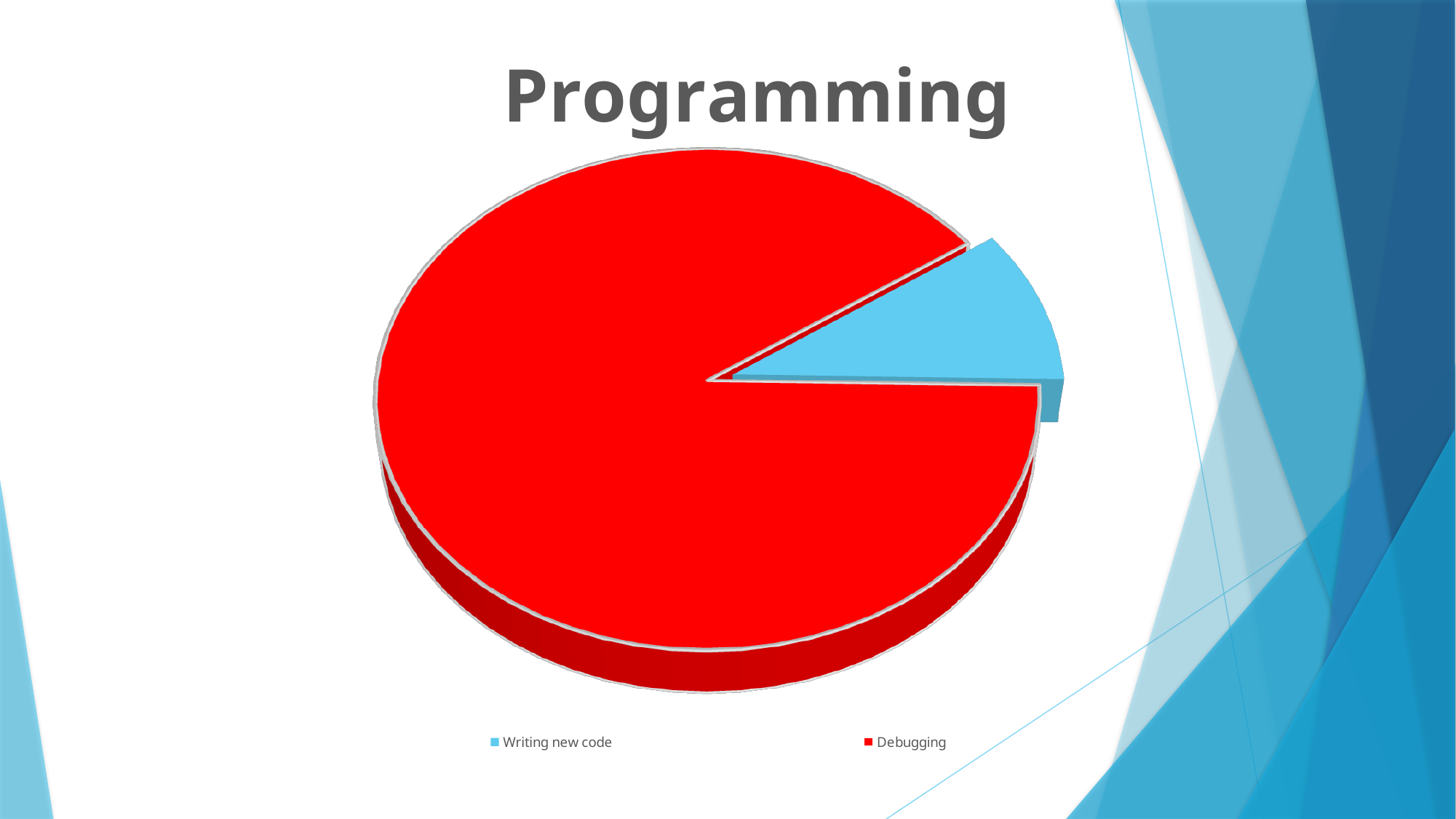
Does the Debugging slice take up more or less than half of the pie? more Which category is shown in blue in the legend? Writing new code Which category has the smallest slice of the pie? Writing new code What kind of chart is shown on the slide? pie chart How many slices does the pie chart have? 2 What is the title of the chart? Programming Which slice is larger, Writing new code or Debugging? Debugging Which category has the largest slice of the pie? Debugging What colour is the Debugging slice? red